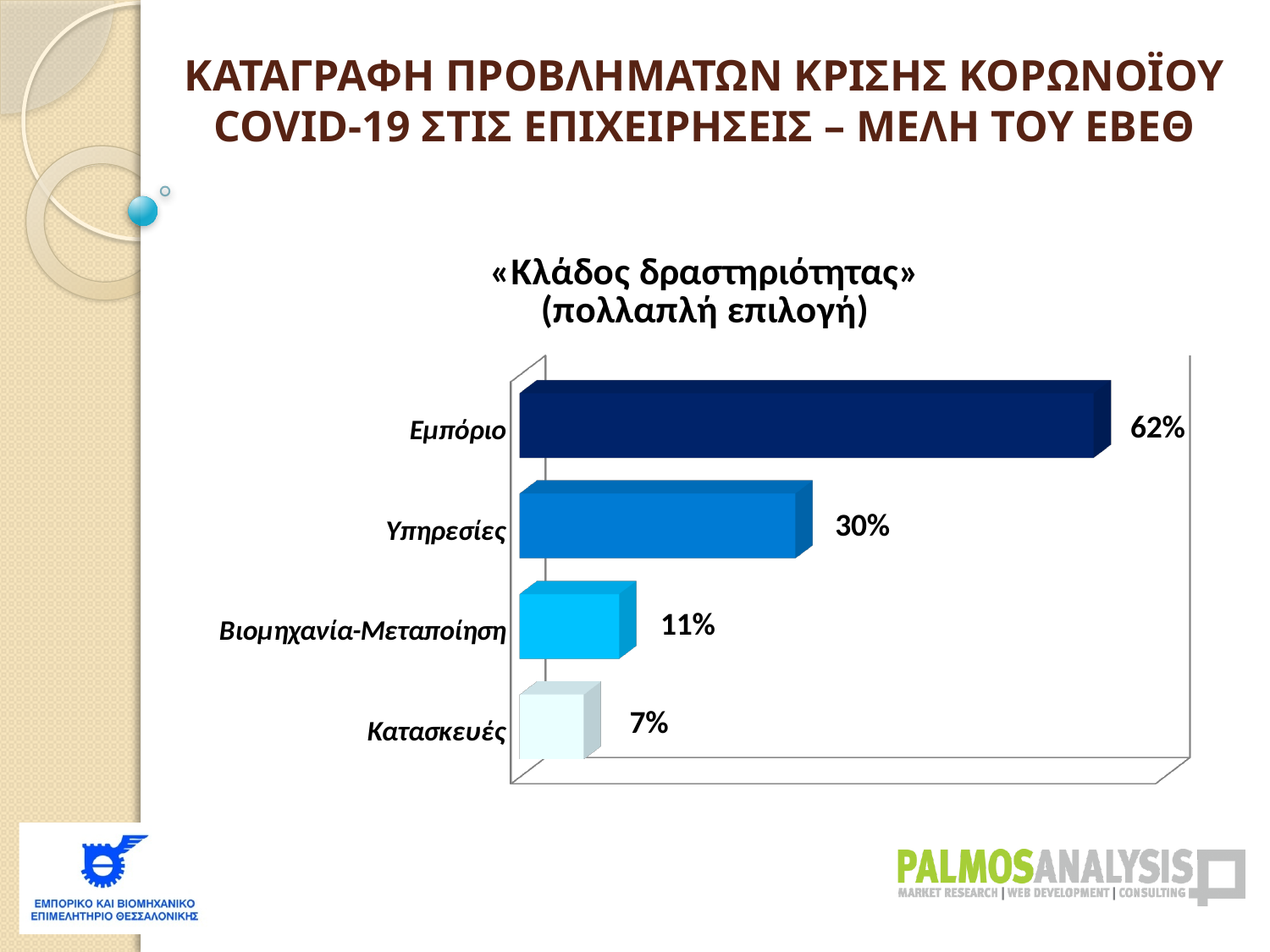
What is the value for Βιομηχανία-Μεταποίηση? 11% What is the value for Εμπόριο? 62% Which category has the lowest value? Κατασκευές What is the value for Κατασκευές? 7% What is the value for Υπηρεσίες? 30% Which is larger, the value for Υπηρεσίες or the value for Βιομηχανία-Μεταποίηση? Υπηρεσίες Which category has the highest value? Εμπόριο What is the difference between the values for Βιομηχανία-Μεταποίηση and Κατασκευές? 4% What is the difference between the values for Εμπόριο and Υπηρεσίες? 32% What kind of chart is shown on the slide? Bar chart How many categories are shown in the chart? 4 What is the title of the chart? «Κλάδος δραστηριότητας» (πολλαπλή επιλογή)